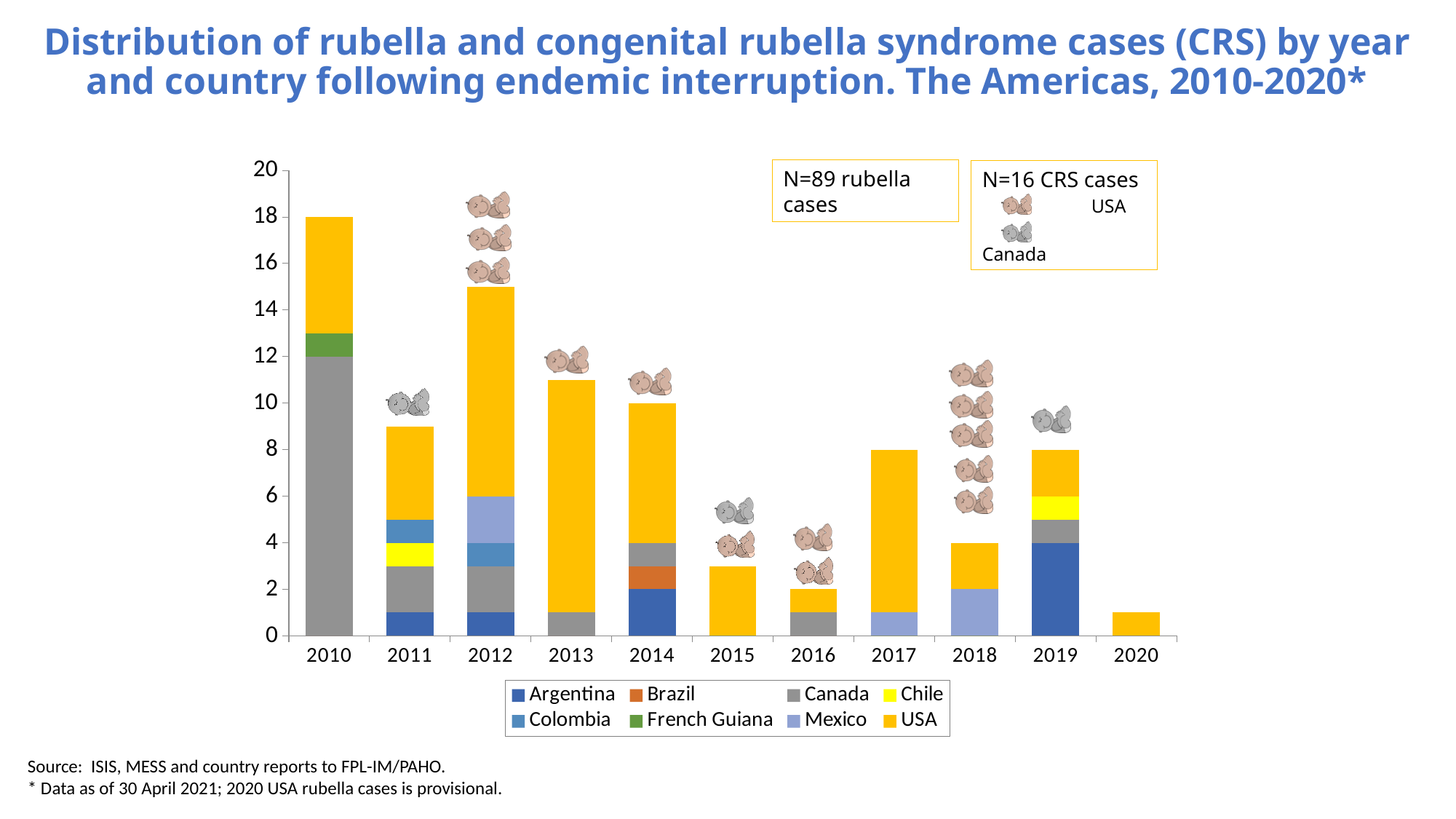
What is the total number of rubella cases in 2017? 8 Which year has the lowest total number of rubella cases? 2020 How many countries does the legend list? 8 Which year has the highest total number of rubella cases? 2010 What is the total number of rubella cases in 2010? 18 How many years are shown along the x axis of the chart? 11 According to the text box on the chart, how many rubella cases are included in total? N=89 rubella cases Is the total number of rubella cases in 2015 greater or less than 4? less Is the total number of rubella cases in 2012 greater or less than 14? greater Which year has more total rubella cases, 2017 or 2018? 2017 What kind of chart is shown on the slide? Stacked bar chart What is the difference between the total rubella cases in 2010 and in 2014? 8